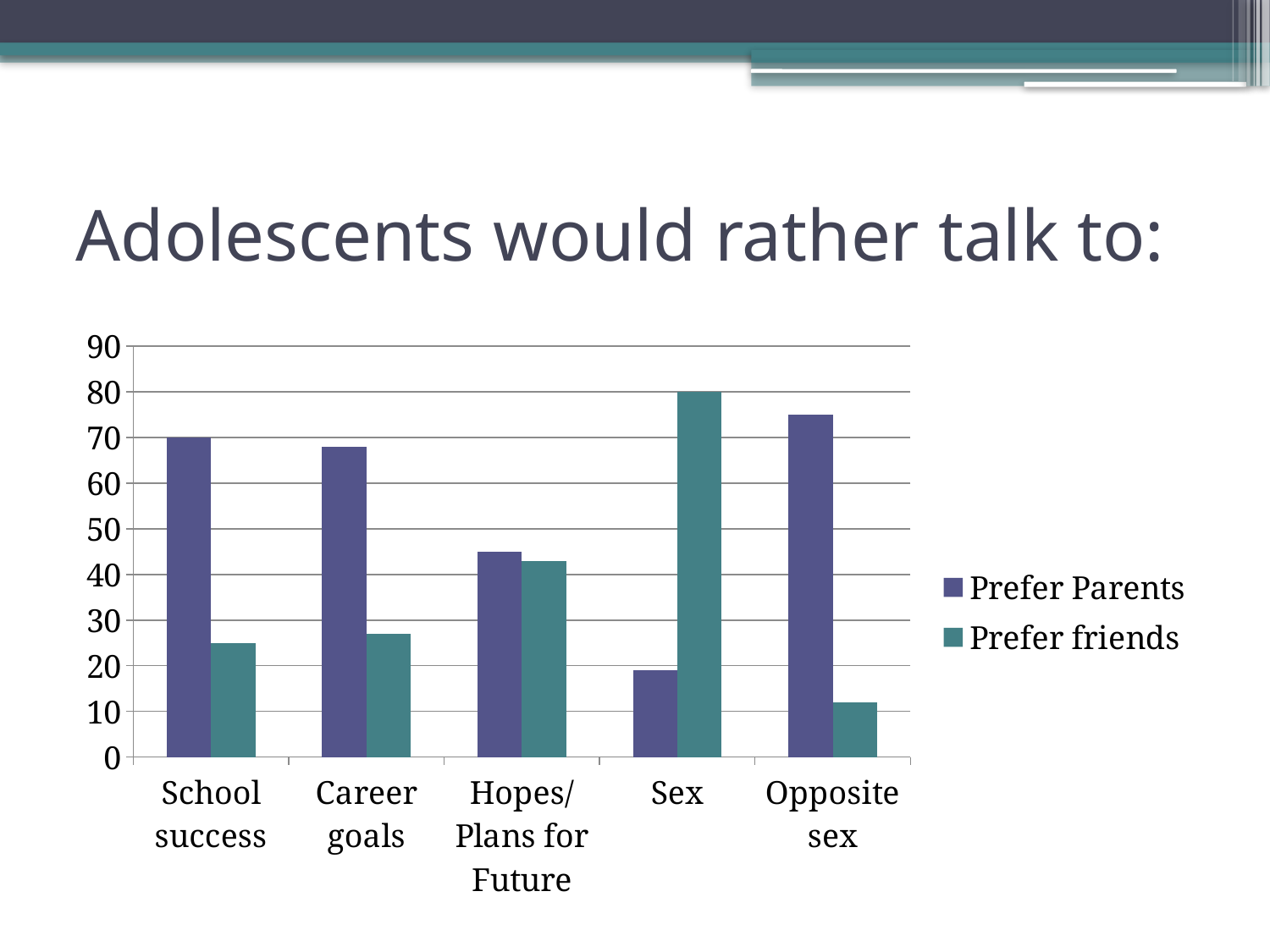
Which category has the lowest Prefer Parents value? Sex What is the Prefer friends value for Sex? 80 Which category has the highest Prefer friends value? Sex Which category has the lowest Prefer friends value? Opposite sex What kind of chart is shown on the slide? Bar chart How many categories are shown on the x axis? 5 Is the Prefer Parents value for Opposite sex greater or less than 70? greater What is the Prefer Parents value for School success? 70 For School success, which is larger: Prefer Parents or Prefer friends? Prefer Parents For Opposite sex, which is larger: Prefer Parents or Prefer friends? Prefer Parents Is the Prefer friends value for Career goals greater or less than 30? less How many series does the legend list? 2